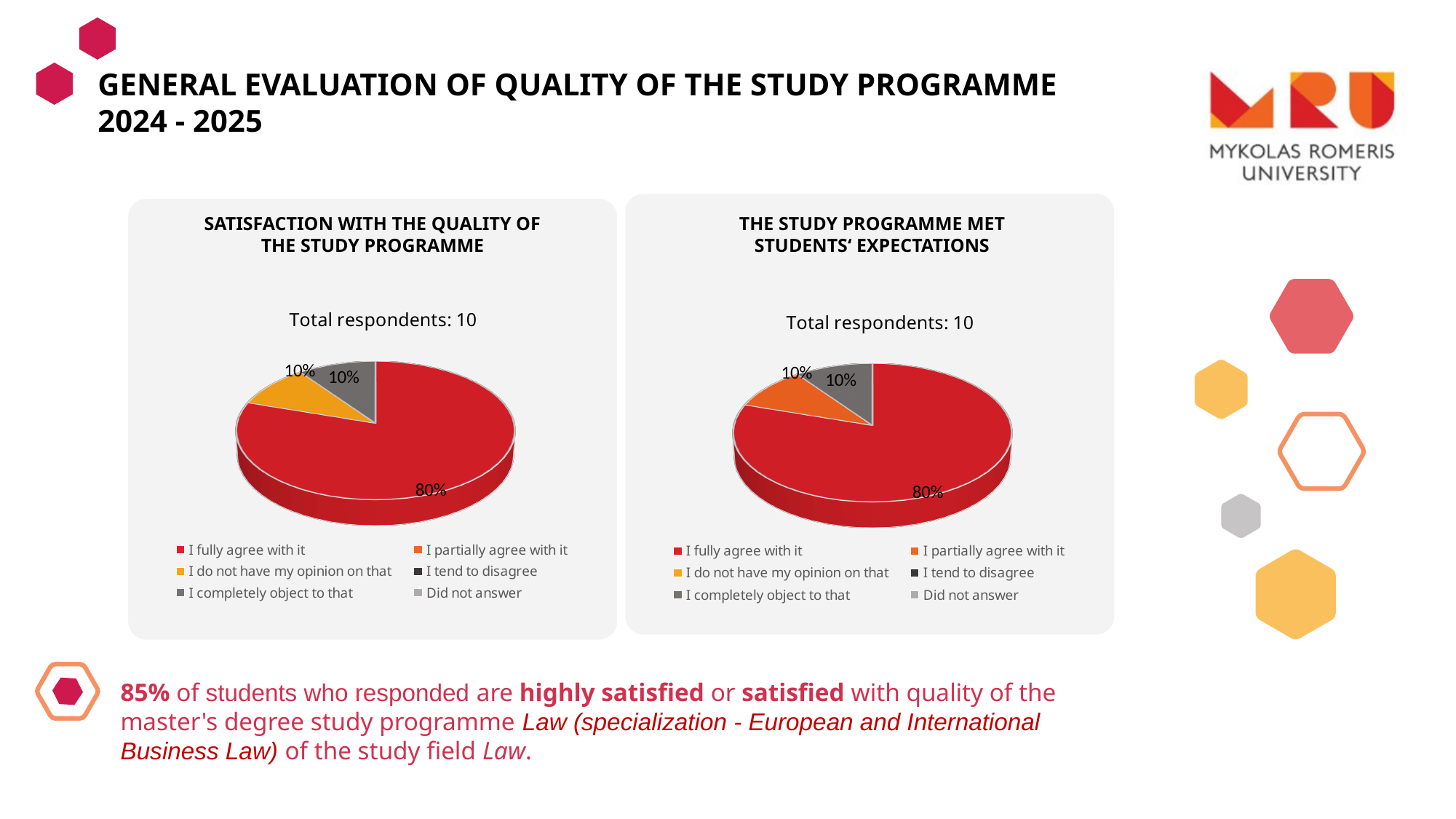
In the 'The study programme met students' expectations' chart, what share of respondents chose 'I partially agree with it'? 10% In the 'Satisfaction with the quality of the study programme' chart, which response has the largest slice? I fully agree with it In the 'The study programme met students' expectations' chart, which is larger: the 'I fully agree with it' slice or the 'I completely object to that' slice? I fully agree with it How many total respondents are reported for the 'The study programme met students' expectations' chart? 10 In the 'Satisfaction with the quality of the study programme' chart, what share of respondents chose 'I completely object to that'? 10% In the 'The study programme met students' expectations' chart, what share of respondents chose 'I fully agree with it'? 80% In the 'The study programme met students' expectations' chart, which response has the largest slice? I fully agree with it In the 'Satisfaction with the quality of the study programme' chart, what is the difference between the 'I fully agree with it' share and the 'I completely object to that' share? 70% What type of chart is used in the 'Satisfaction with the quality of the study programme' panel? Pie chart How many entries does the legend of the 'The study programme met students' expectations' chart list? 6